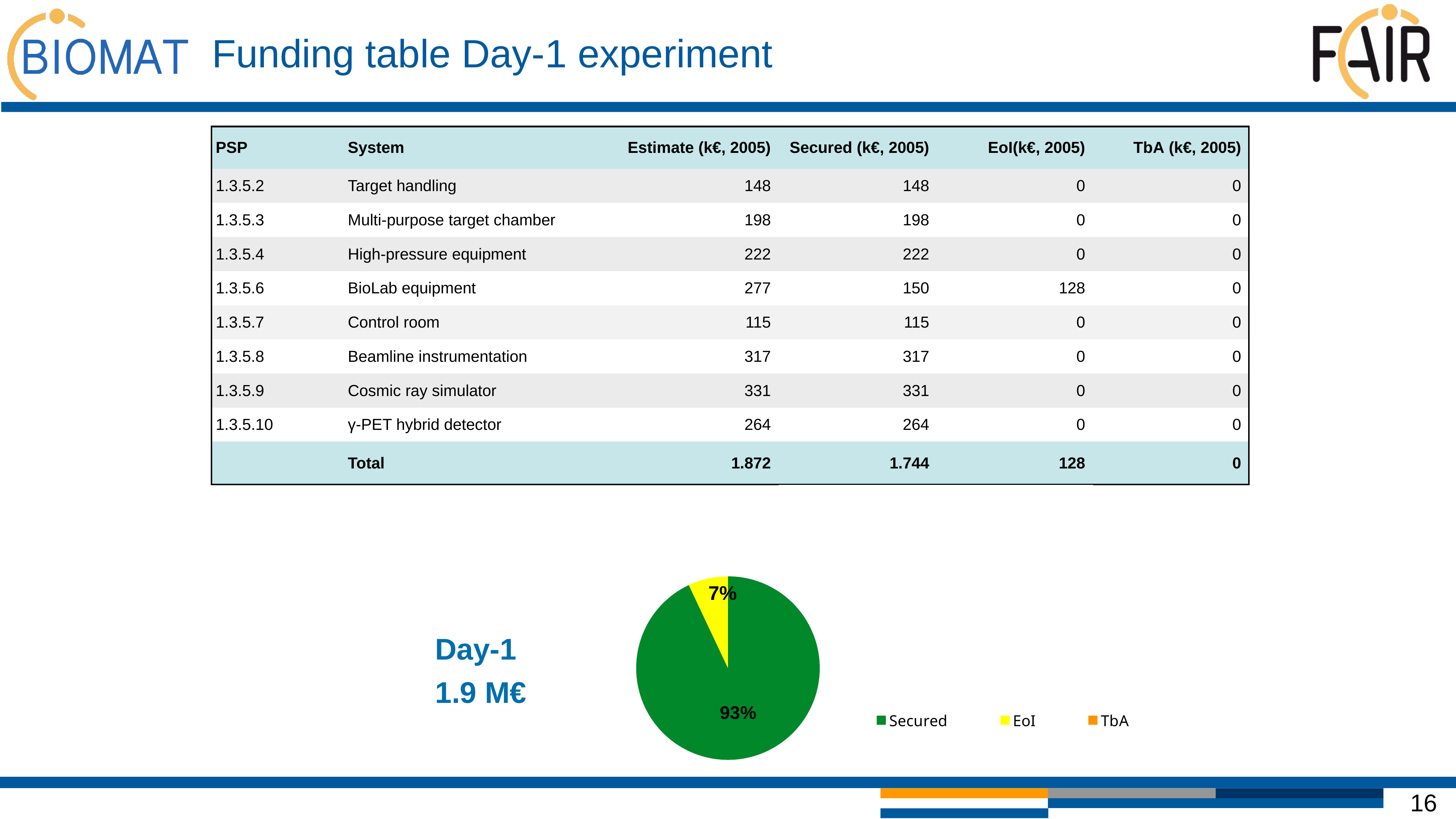
Is the share of the Secured slice in the pie chart greater or less than 50%? greater In the pie chart, what share does the EoI slice have? 7% How many entries does the pie chart's legend list? 3 Which of the two labelled slices in the pie chart is smaller, Secured or EoI? EoI Which slice of the pie chart is the largest? Secured What colour is the Secured slice in the pie chart? green What is the difference in percentage points between the Secured and EoI slices of the pie chart? 86 What kind of chart is shown on the slide? pie chart What colour is the EoI slice in the pie chart? yellow What total amount is written next to the pie chart for Day-1? 1.9 M€ In the pie chart, what share does the Secured slice have? 93%